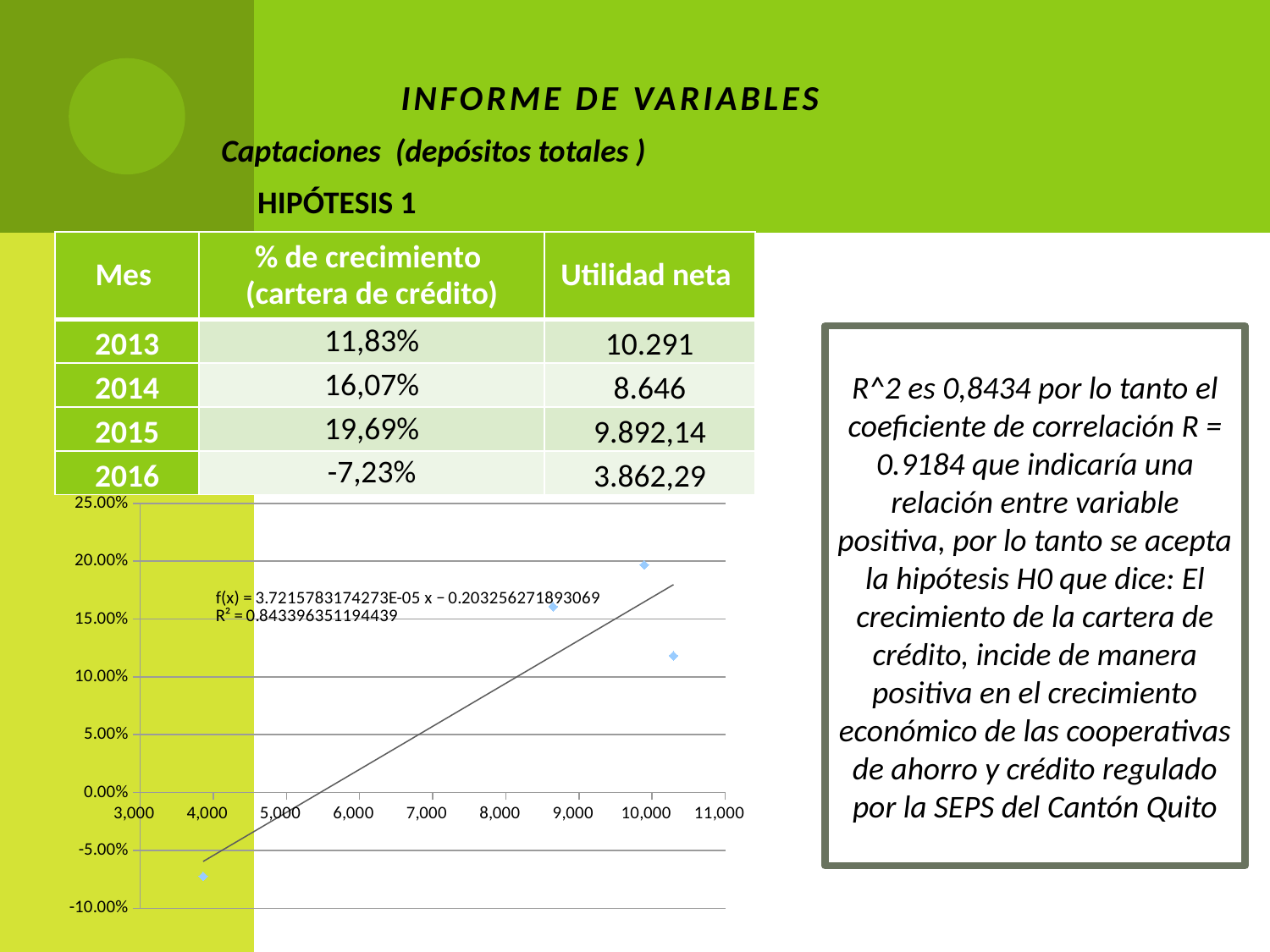
What R² value is printed on the chart? 0.843396351194439 Is the value of the highest plotted point on the chart greater or less than 15.00%? greater How many data points are plotted on the scatter chart? 4 Is the value of the point plotted near x = 8,700 greater or less than 15.00%? greater What trendline equation is printed on the chart? f(x) = 3.7215783174273E-05 x − 0.203256271893069 Does the trendline on the chart rise or fall as the x-axis values increase? rises Is the value of the point plotted near x = 10,300 greater or less than 15.00%? less How many plotted points on the chart lie below 0.00%? 1 What kind of chart is shown on the slide? scatter chart